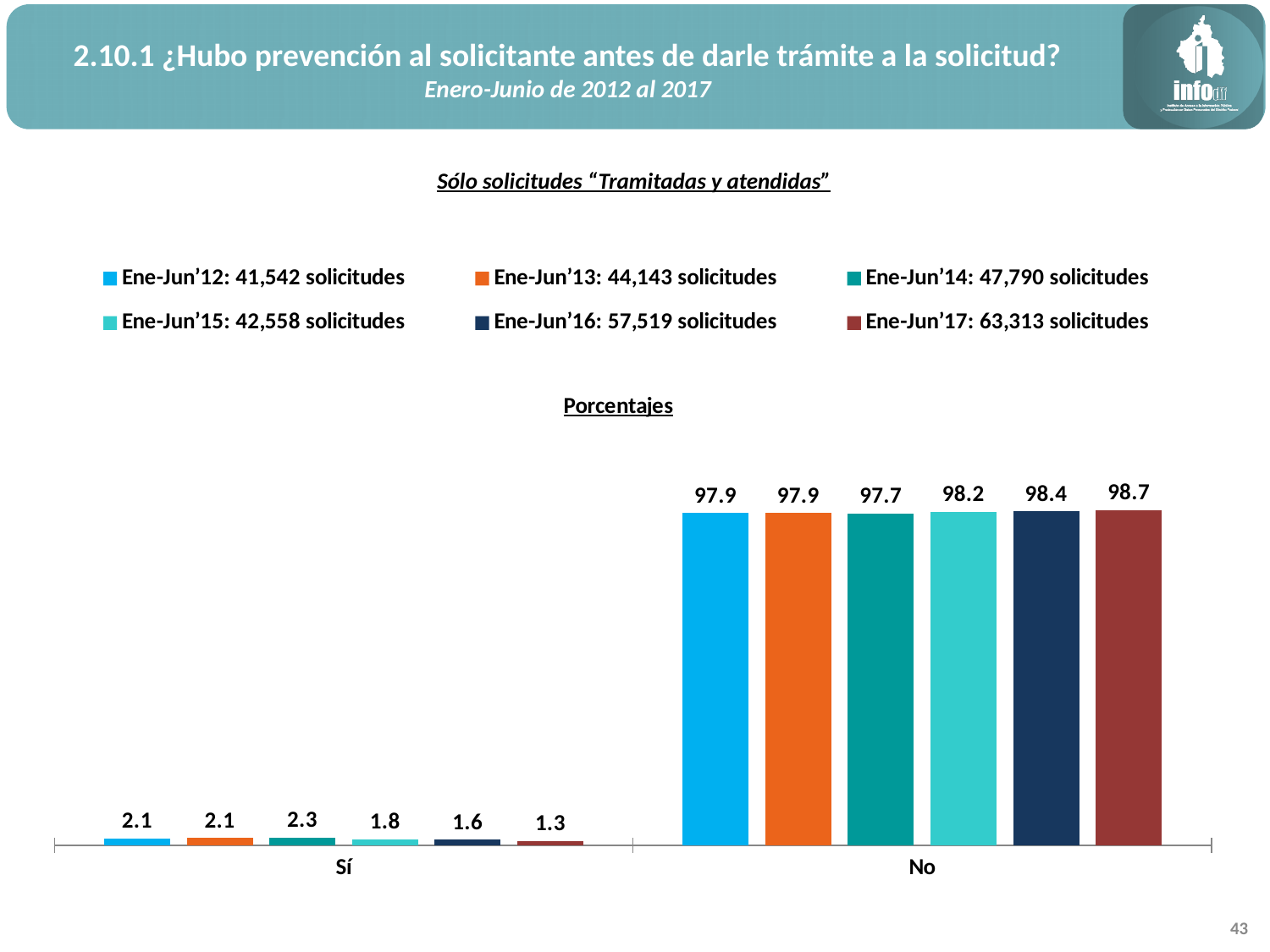
Which series has the lowest value for "Sí"? Ene-Jun'17 What kind of chart is shown on the slide? Bar chart What is the value for "Sí" in the Ene-Jun'14 series? 2.3 Which series has the lowest value for "No"? Ene-Jun'14 How many series does the legend list? 6 Which is larger: the "Sí" value for Ene-Jun'15 or for Ene-Jun'16? Ene-Jun'15 How many categories are shown on the x axis? 2 What is the value for "No" in the Ene-Jun'17 series? 98.7 Which series has the highest value for "Sí"? Ene-Jun'14 What is the difference between the "No" values for Ene-Jun'17 and Ene-Jun'12? 0.8 What is the value for "Sí" in the Ene-Jun'16 series? 1.6 According to the legend, how many solicitudes does the Ene-Jun'16 series represent? 57,519 solicitudes